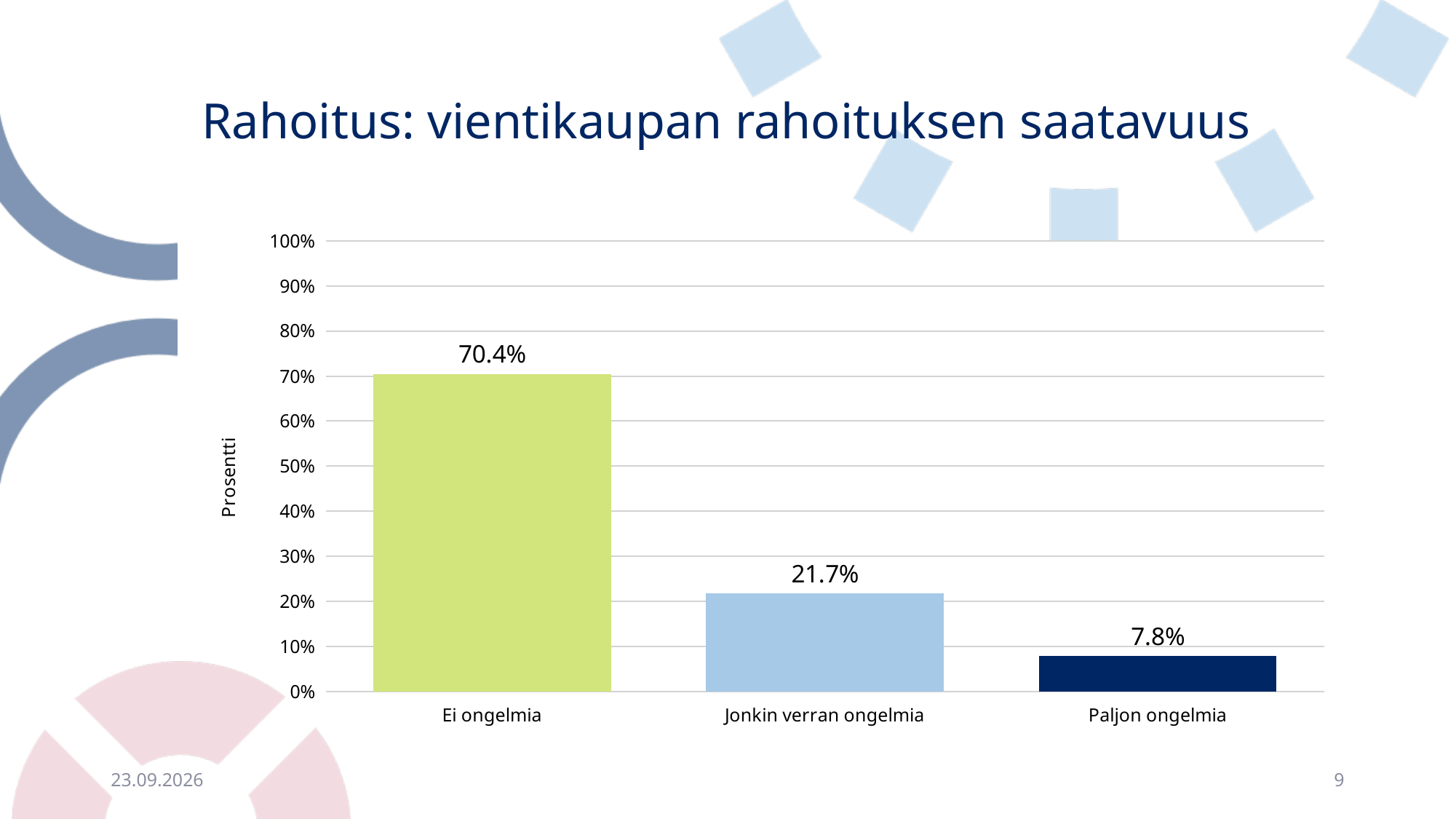
Is the value for "Jonkin verran ongelmia" greater or less than 20%? greater What kind of chart is shown on the slide? Bar chart What is the difference between the values for "Jonkin verran ongelmia" and "Paljon ongelmia"? 13.9% What is the value for "Ei ongelmia"? 70.4% What is the value for "Paljon ongelmia"? 7.8% How many categories are shown on the x axis? 3 Which is larger, the value for "Jonkin verran ongelmia" or "Paljon ongelmia"? Jonkin verran ongelmia Which category has the lowest value? Paljon ongelmia What is the value for "Jonkin verran ongelmia"? 21.7% What is the difference between the values for "Ei ongelmia" and "Jonkin verran ongelmia"? 48.7% What is the label of the vertical axis? Prosentti Which category has the highest value? Ei ongelmia